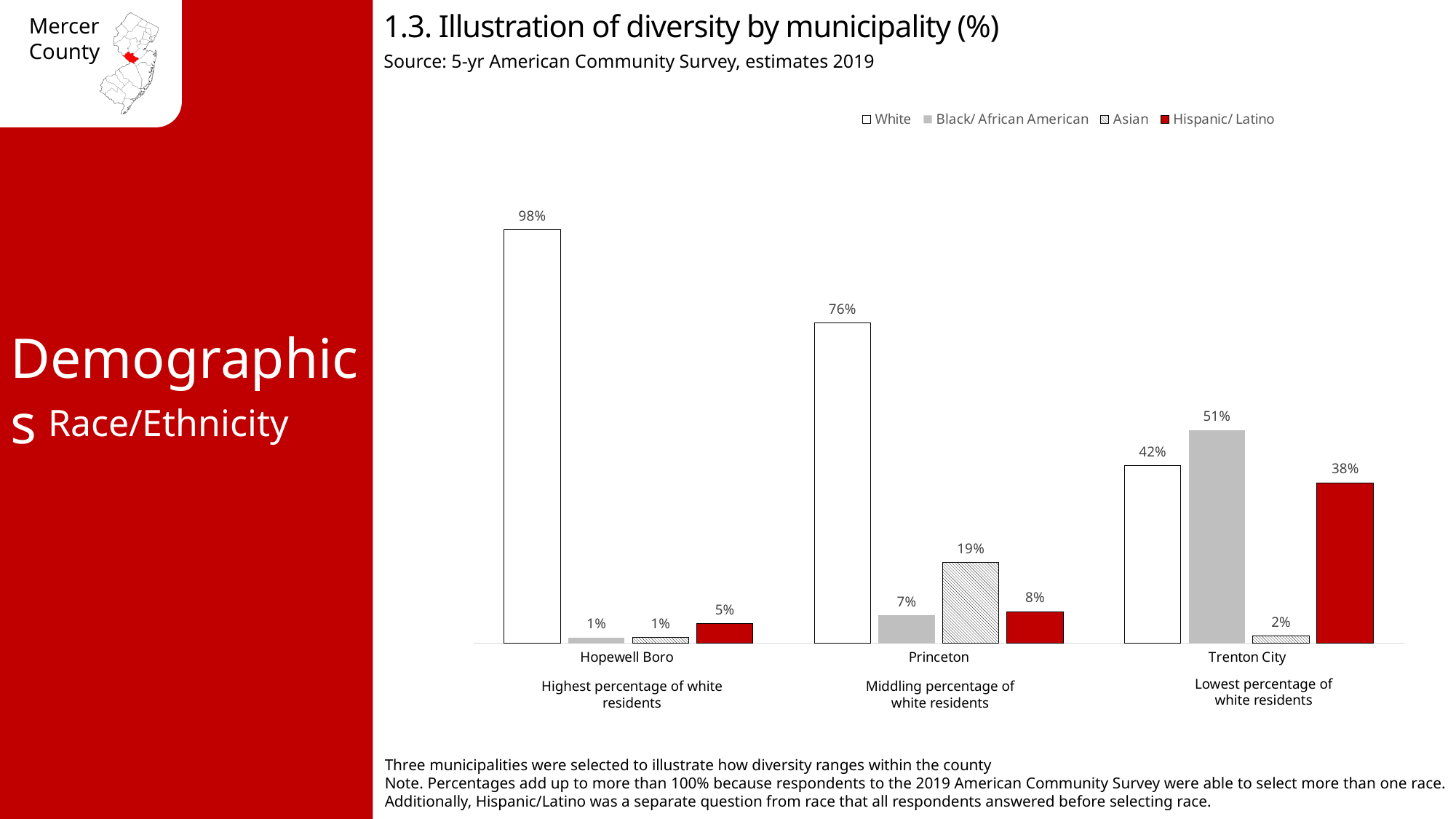
Which series is shown in red? Hispanic/ Latino What is the White percentage for Hopewell Boro? 98% What is the Asian percentage for Princeton? 19% How many municipalities are shown on the x axis? 3 What is the Black/ African American percentage for Trenton City? 51% What kind of chart is shown on the slide? Bar chart How many series does the legend list? 4 What is the Hispanic/ Latino percentage for Trenton City? 38% What is the difference between the White percentage for Hopewell Boro and for Princeton? 22% Which municipality has the lowest Hispanic/ Latino percentage? Hopewell Boro Which municipality has the highest White percentage? Hopewell Boro Which is larger for Trenton City: the White percentage or the Black/ African American percentage? Black/ African American